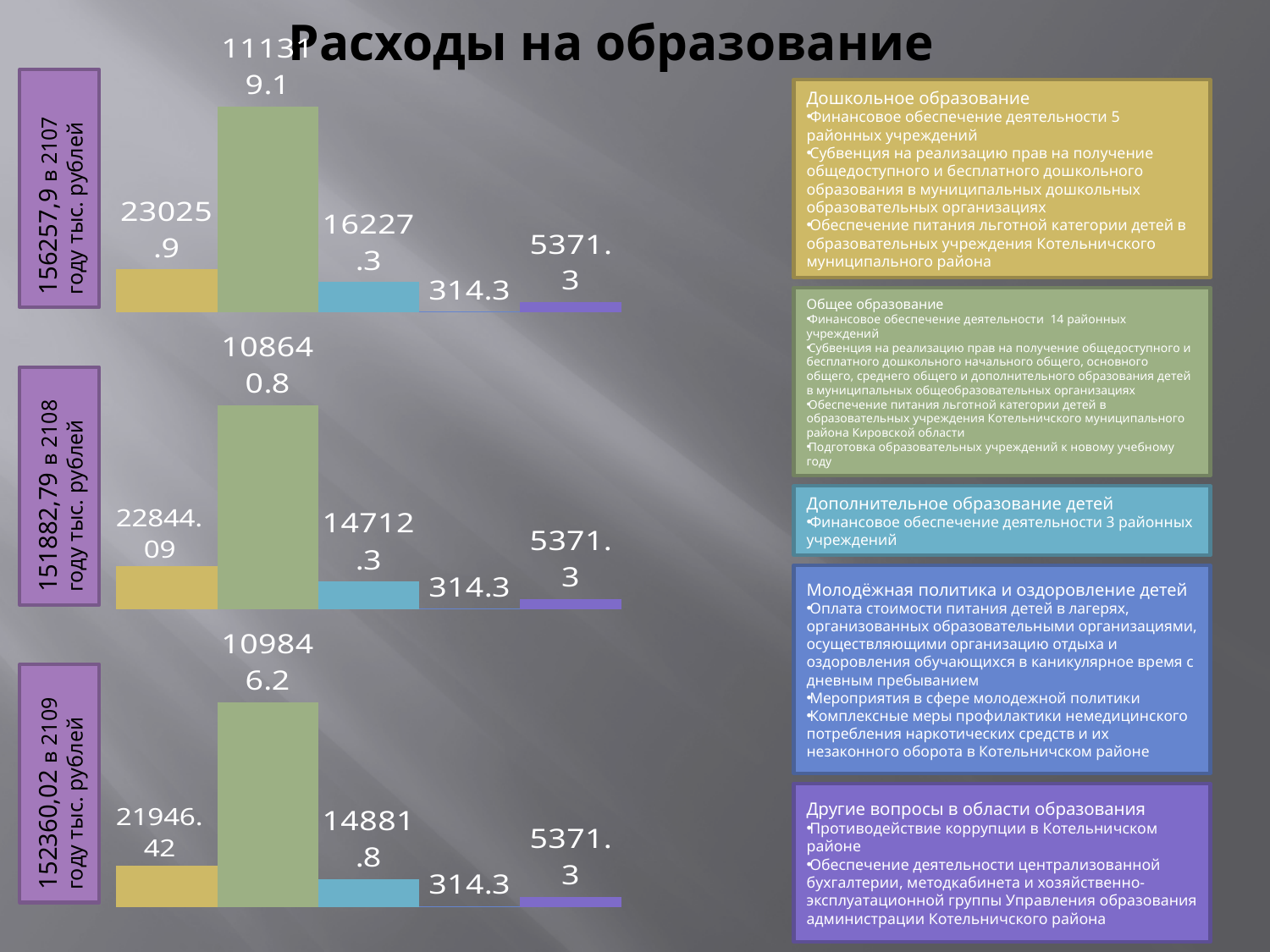
On the chart labelled '151882,79 в 2108 году тыс. рублей', what is the value of the last (purple) bar? 5371.3 On the chart labelled '151882,79 в 2108 году тыс. рублей', what is the difference between the first (yellow) bar and the third (blue) bar? 8131.79 On the chart labelled '156257,9 в 2107 году тыс. рублей', what is the value of the first (yellow) bar? 23025.9 On the chart labelled '156257,9 в 2107 году тыс. рублей', what is the smallest value shown? 314.3 On the chart labelled '152360,02 в 2109 году тыс. рублей', what is the value of the third (blue) bar? 14881.8 What type of charts are shown on the slide? Bar charts On the chart labelled '152360,02 в 2109 году тыс. рублей', which bar is the highest? The green bar (109846.2) On the chart labelled '151882,79 в 2108 году тыс. рублей', what is the value of the tallest (green) bar? 108640.8 On the chart labelled '152360,02 в 2109 году тыс. рублей', which is larger: the yellow bar or the blue bar? The yellow bar (21946.42) How many separate charts are shown on the slide? 3 On the chart labelled '152360,02 в 2109 году тыс. рублей', what is the value of the first (yellow) bar? 21946.42 How many bars does each of the three charts on the slide contain? 5